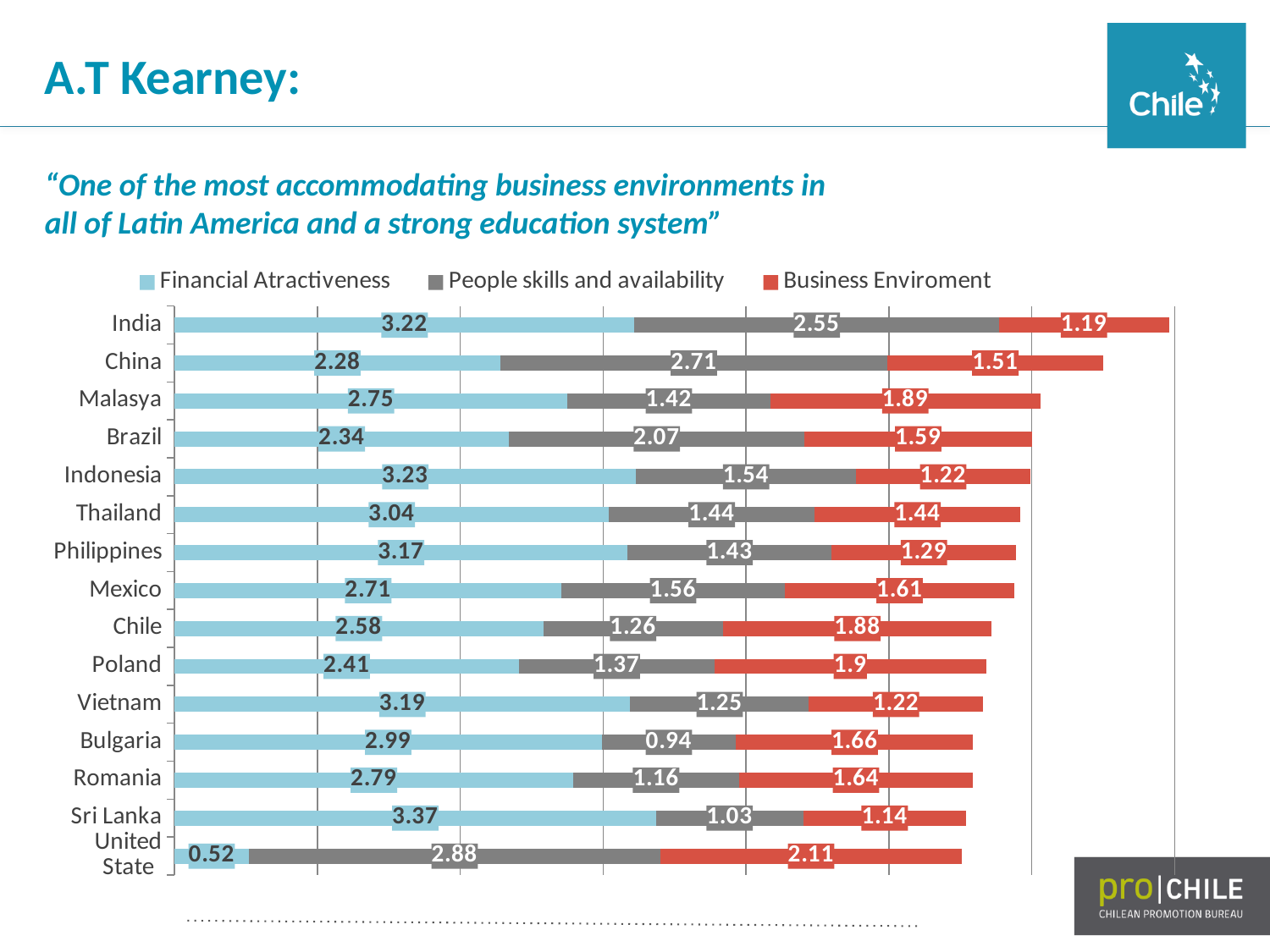
What is the difference between the Business Enviroment values for Chile and Mexico? 0.27 Which country has the lowest Financial Atractiveness value? United State What is the People skills and availability value for India? 2.55 What is the Financial Atractiveness value for Chile? 2.58 Which is larger, the People skills and availability value for China or for Brazil? China How many countries are shown in the chart? 15 What is the Business Enviroment value for Malasya? 1.89 How many series does the legend list? 3 Which country has the highest Business Enviroment value? United State What is the total of the stacked bar for Chile? 5.72 What kind of chart is shown on the slide? Stacked bar chart Which country has the highest Financial Atractiveness value? Sri Lanka